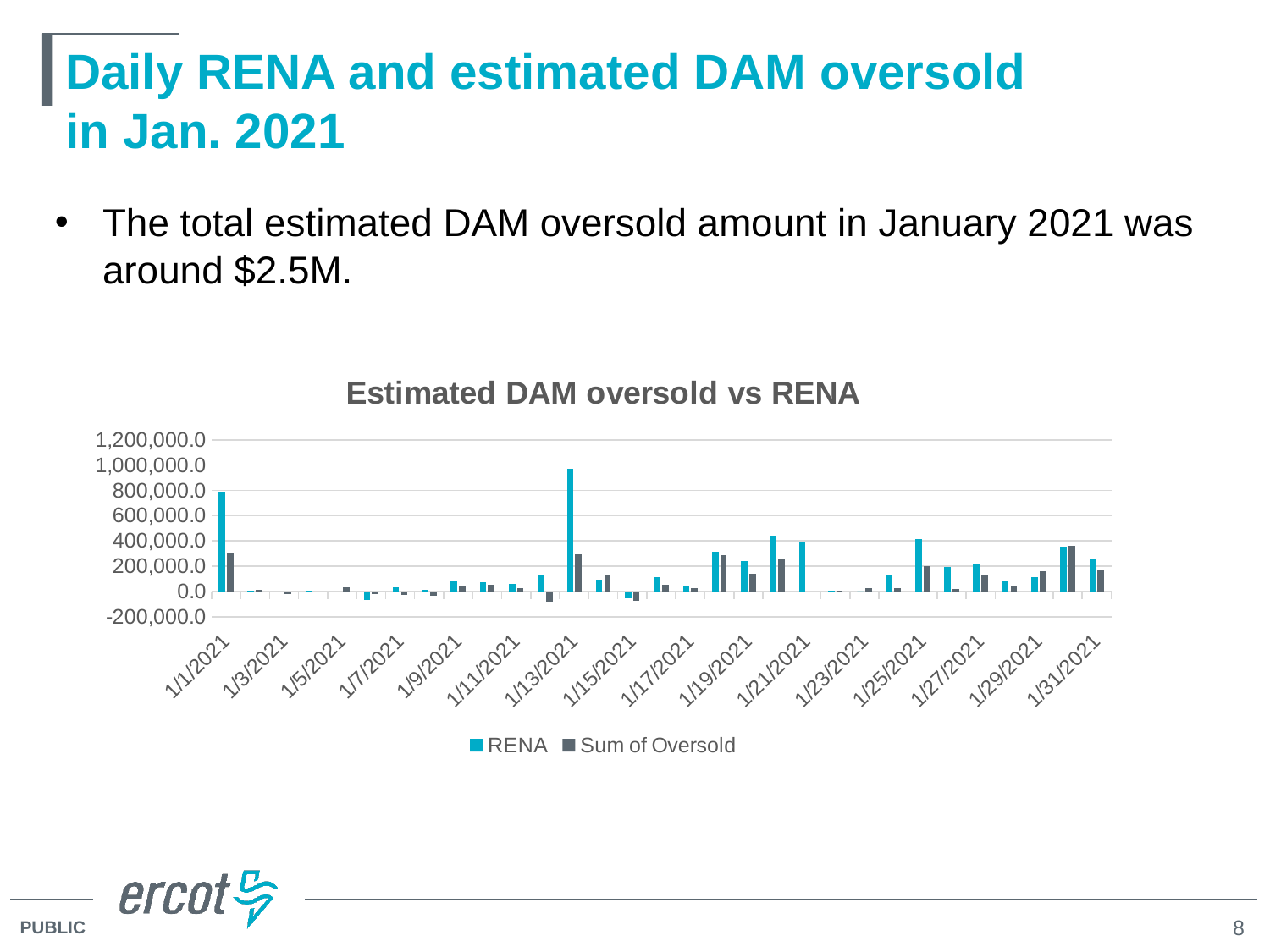
On which date does the RENA series reach its highest value? 1/13/2021 What kind of chart is shown on the slide? Bar chart On 1/1/2021, which is larger: RENA or Sum of Oversold? RENA How many series does the chart legend list? 2 Is the Sum of Oversold value on 1/1/2021 greater or less than 200,000.0? greater Is the RENA value on 1/13/2021 greater or less than 800,000.0? greater What is the title of the chart? Estimated DAM oversold vs RENA What is the first date label shown on the x axis? 1/1/2021 What are the two series named in the legend? RENA and Sum of Oversold On 1/13/2021, which is larger: RENA or Sum of Oversold? RENA Is the RENA value on 1/1/2021 greater or less than 600,000.0? greater